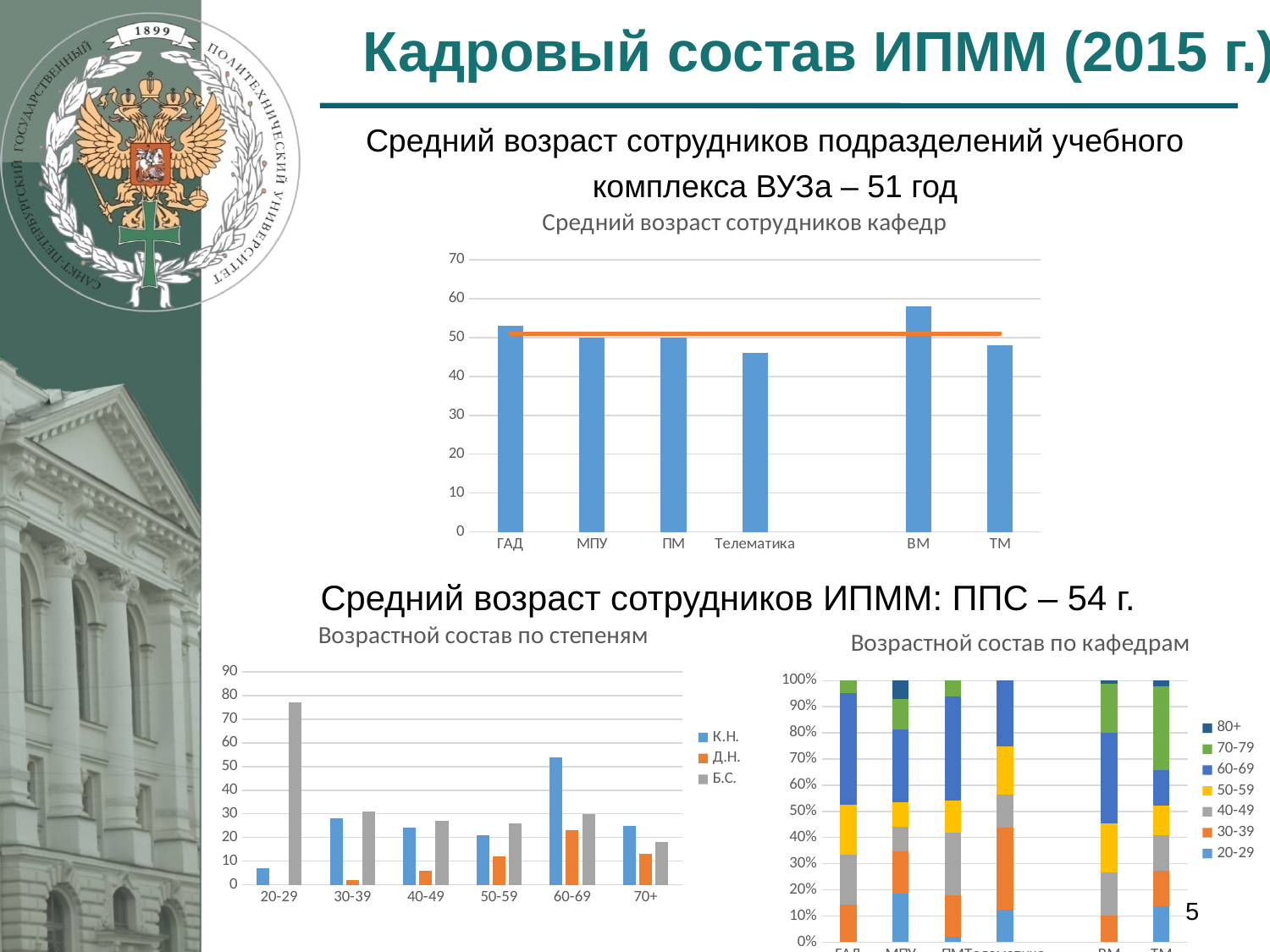
In the 'Возрастной состав по степеням' chart, which age group has the highest value for the Б.С. series? 20-29 In the 'Средний возраст сотрудников кафедр' chart, which is larger, the value for ВМ or the value for ГАД? ВМ In the 'Средний возраст сотрудников кафедр' chart, how many departments are shown on the x axis? 6 How many series does the legend of the 'Возрастной состав по кафедрам' chart list? 7 In the 'Средний возраст сотрудников кафедр' chart, which department has the highest average age? ВМ In the 'Возрастной состав по степеням' chart, which age group has the highest value for the К.Н. series? 60-69 In the 'Средний возраст сотрудников кафедр' chart, is the value for Телематика greater or less than 50? less In the 'Средний возраст сотрудников кафедр' chart, is the value for ВМ greater or less than 50? greater What kind of chart is the 'Средний возраст сотрудников кафедр' chart? Combination bar and line chart In the 'Возрастной состав по степеням' chart, is the Б.С. value for 20-29 greater or less than 70? greater In the 'Возрастной состав по степеням' chart, for the 60-69 age group, which is larger, К.Н. or Б.С.? К.Н. How many series does the legend of the 'Возрастной состав по степеням' chart list? 3